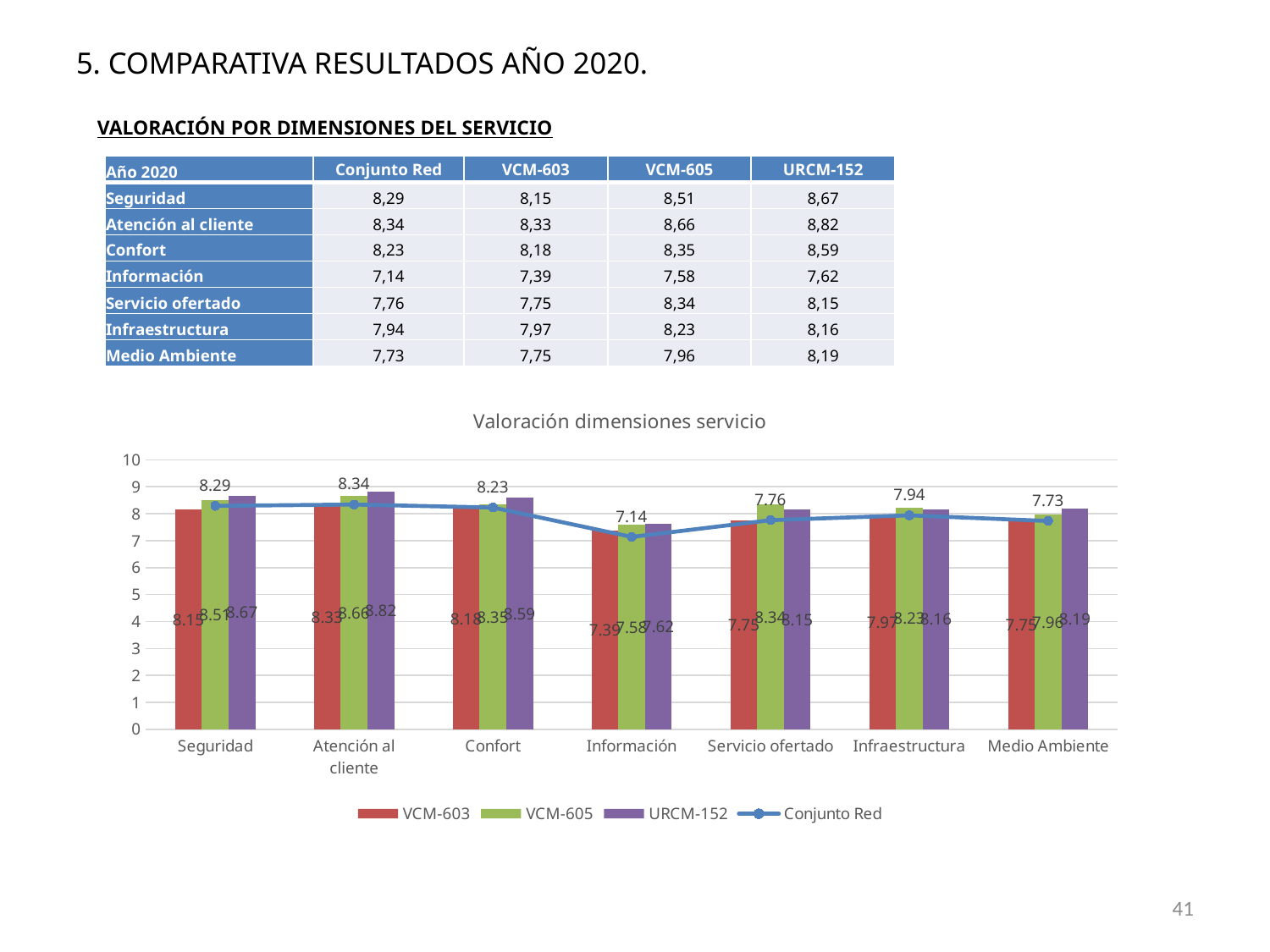
Which category has the highest Conjunto Red value in the chart? Atención al cliente Is the URCM-152 value for Información greater or less than 8? less Which category has the lowest Conjunto Red value in the chart? Información What is the Conjunto Red value for Seguridad in the chart? 8.29 What kind of chart is shown on the slide? Bar chart with a line series What is the Conjunto Red value for Medio Ambiente in the chart? 7.73 What is the title of the chart? Valoración dimensiones servicio What is the Conjunto Red value for Información in the chart? 7.14 What is the difference between the Conjunto Red values for Atención al cliente and Información? 1.20 Is the Conjunto Red value for Infraestructura greater or less than the Conjunto Red value for Servicio ofertado? greater How many series does the chart legend list? 4 How many categories are shown on the x axis of the chart? 7